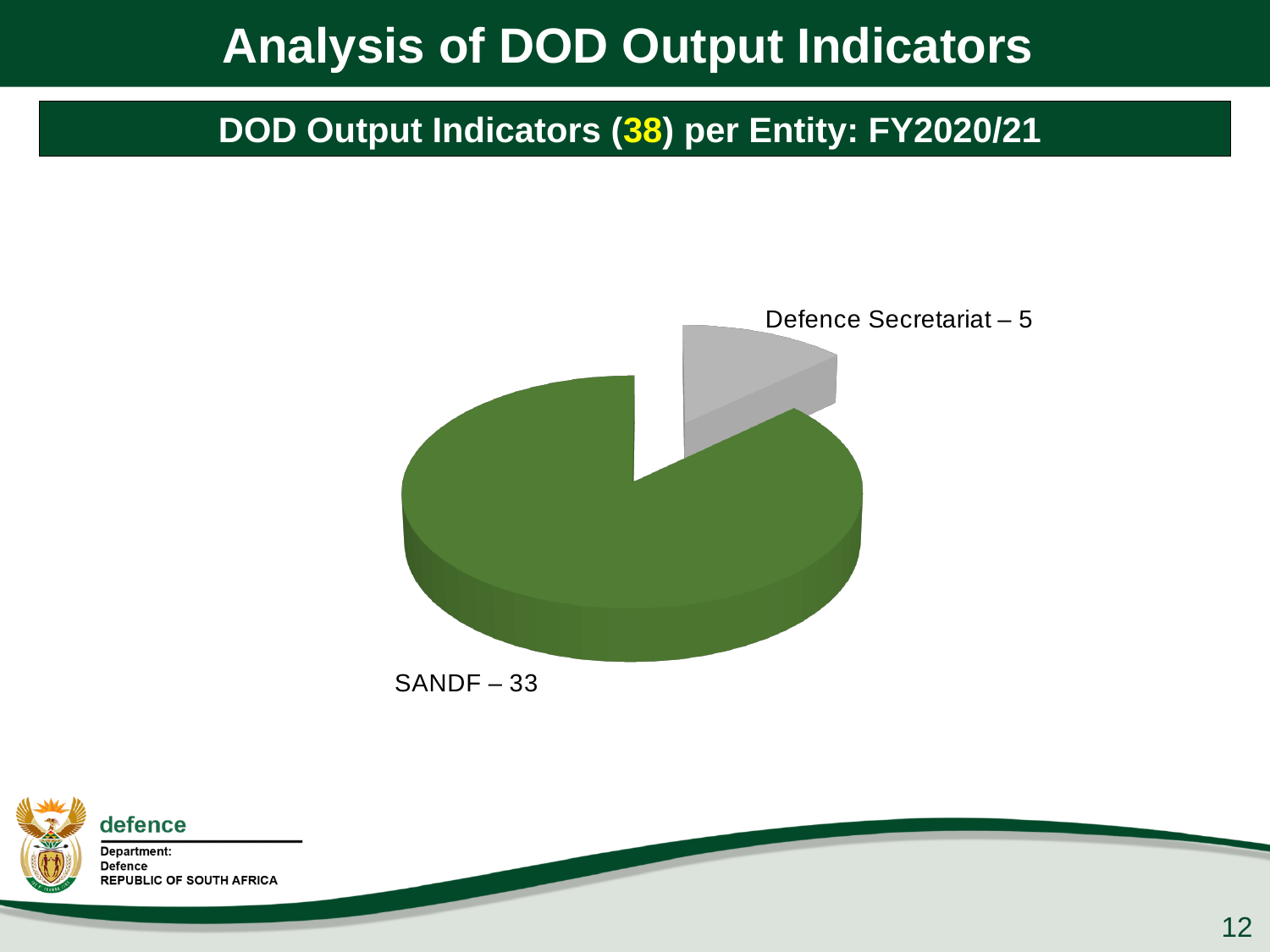
What colour is the SANDF slice? Green How many slices does the pie chart have? 2 Which entity has the largest slice of the pie? SANDF How many output indicators does the Defence Secretariat slice represent? 5 What is the difference between the SANDF and Defence Secretariat indicator counts? 28 How many output indicators does the SANDF slice represent? 33 What type of chart is shown on the slide? Pie chart What colour is the Defence Secretariat slice? Grey Which entity has the smallest slice of the pie? Defence Secretariat Which has more output indicators, SANDF or Defence Secretariat? SANDF What is the total number of DOD output indicators shown in the pie chart? 38